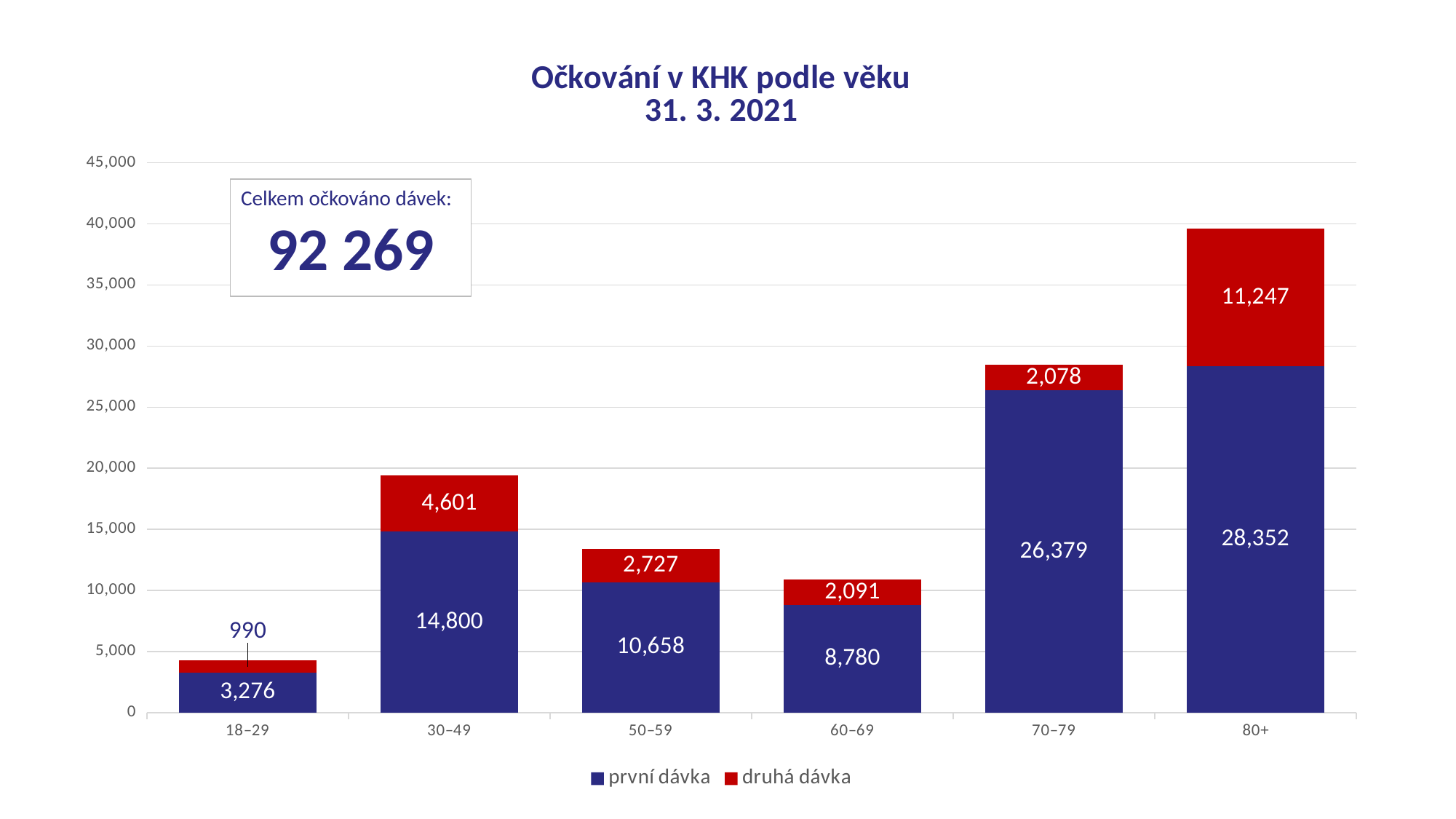
What is the total of the stacked bar for the 60–69 age group? 10,871 How many series does the legend list? 2 What is the value of první dávka for the 30–49 age group? 14,800 What kind of chart is shown on the slide? stacked bar chart What is the value of druhá dávka for the 80+ age group? 11,247 How many age groups are shown on the x axis? 6 What is the value of druhá dávka for the 18–29 age group? 990 Which is larger: druhá dávka for 50–59 or druhá dávka for 60–69? druhá dávka for 50–59 Which age group has the highest value of první dávka? 80+ What is the difference between první dávka for 80+ and první dávka for 70–79? 1,973 Which age group has the lowest value of druhá dávka? 18–29 What is the total of the stacked bar for the 80+ age group? 39,599